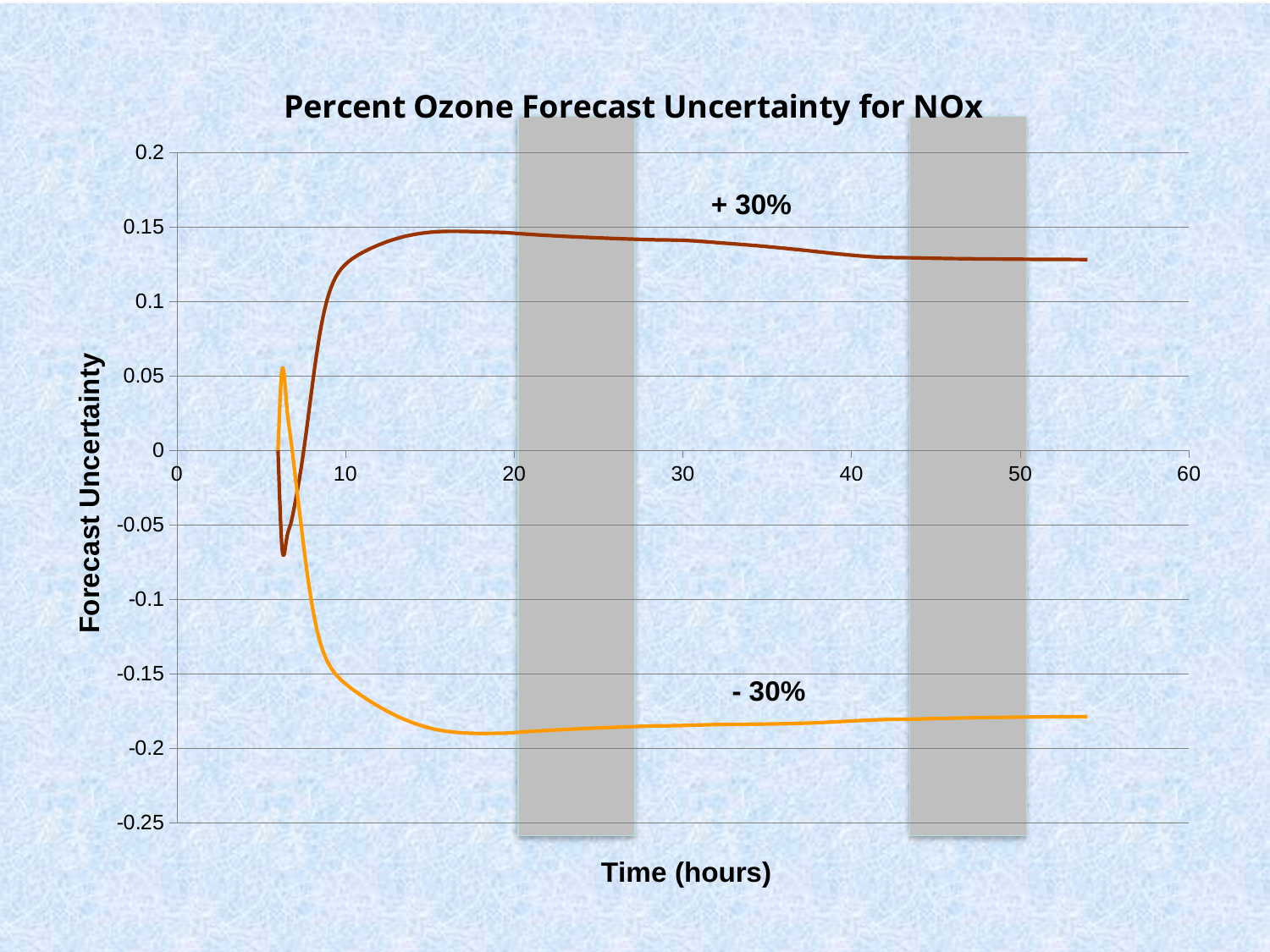
Is the value of the + 30% line at 50 hours greater or less than 0.15? less What is the label of the x axis? Time (hours) What is the title of the chart? Percent Ozone Forecast Uncertainty for NOx At 40 hours, which line has the higher value, + 30% or - 30%? + 30% Between 20 and 50 hours, does the + 30% line rise or fall? fall Is the value of the - 30% line at 50 hours greater or less than -0.2? greater Is the value of the - 30% line at 30 hours greater or less than -0.15? less How many series (lines) are plotted on the chart? 2 What kind of chart is shown on the slide? Line chart Between 20 and 50 hours, does the - 30% line rise or fall? rise